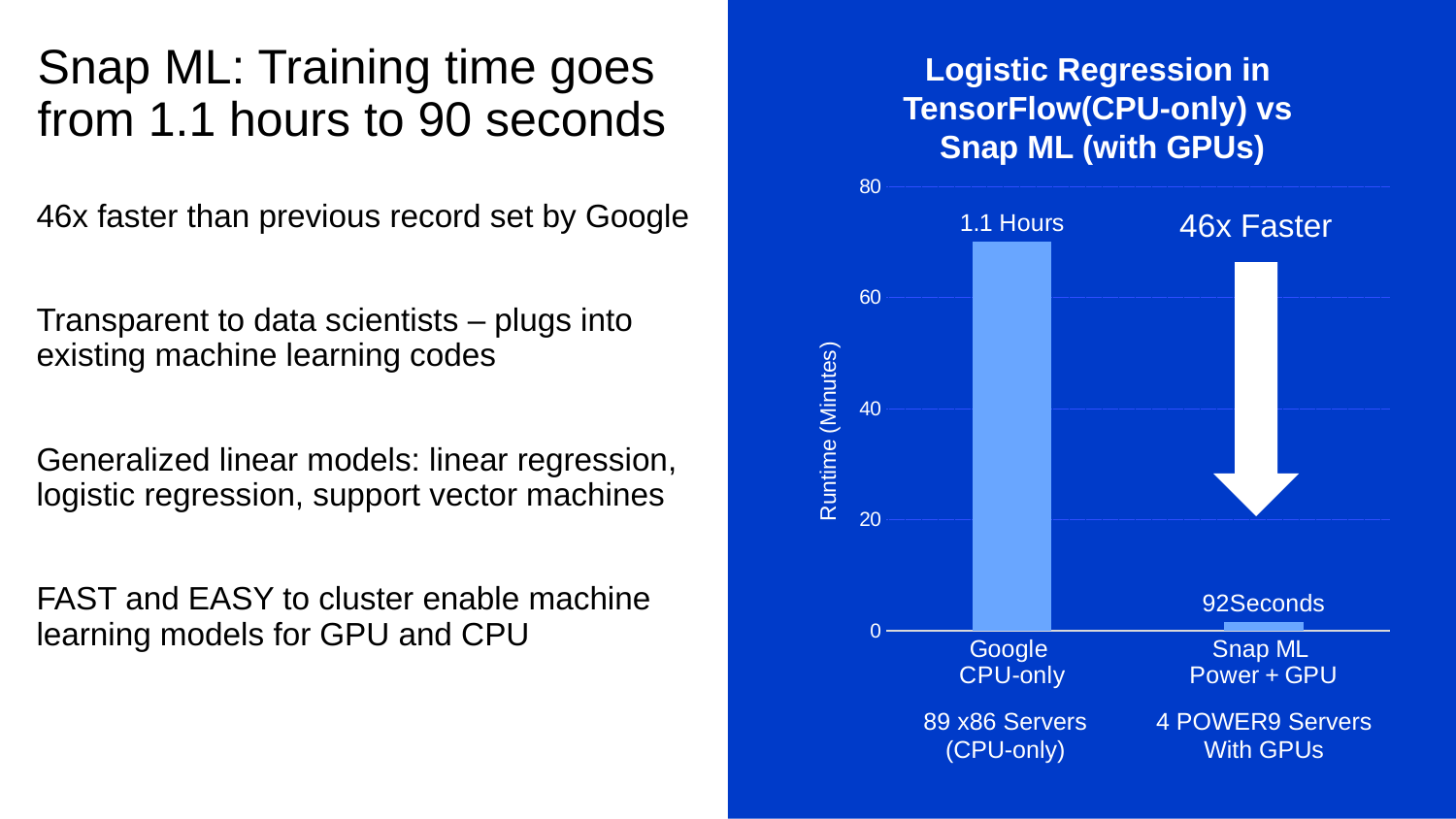
What is the title of the chart? Logistic Regression in TensorFlow(CPU-only) vs Snap ML (with GPUs) Is the runtime for Snap ML Power + GPU greater or less than 20 minutes? less What runtime is labelled on the bar for Google CPU-only? 1.1 Hours What kind of chart is shown on the slide? bar chart Is the runtime for Google CPU-only greater or less than 40 minutes? greater What is the label on the vertical axis of the chart? Runtime (Minutes) Which category has the lowest runtime? Snap ML Power + GPU How many bars are plotted in the chart? 2 What runtime is labelled on the bar for Snap ML Power + GPU? 92Seconds Is the runtime for Google CPU-only greater or less than 60 minutes? greater Which category has the highest runtime? Google CPU-only Which has the larger runtime, Google CPU-only or Snap ML Power + GPU? Google CPU-only